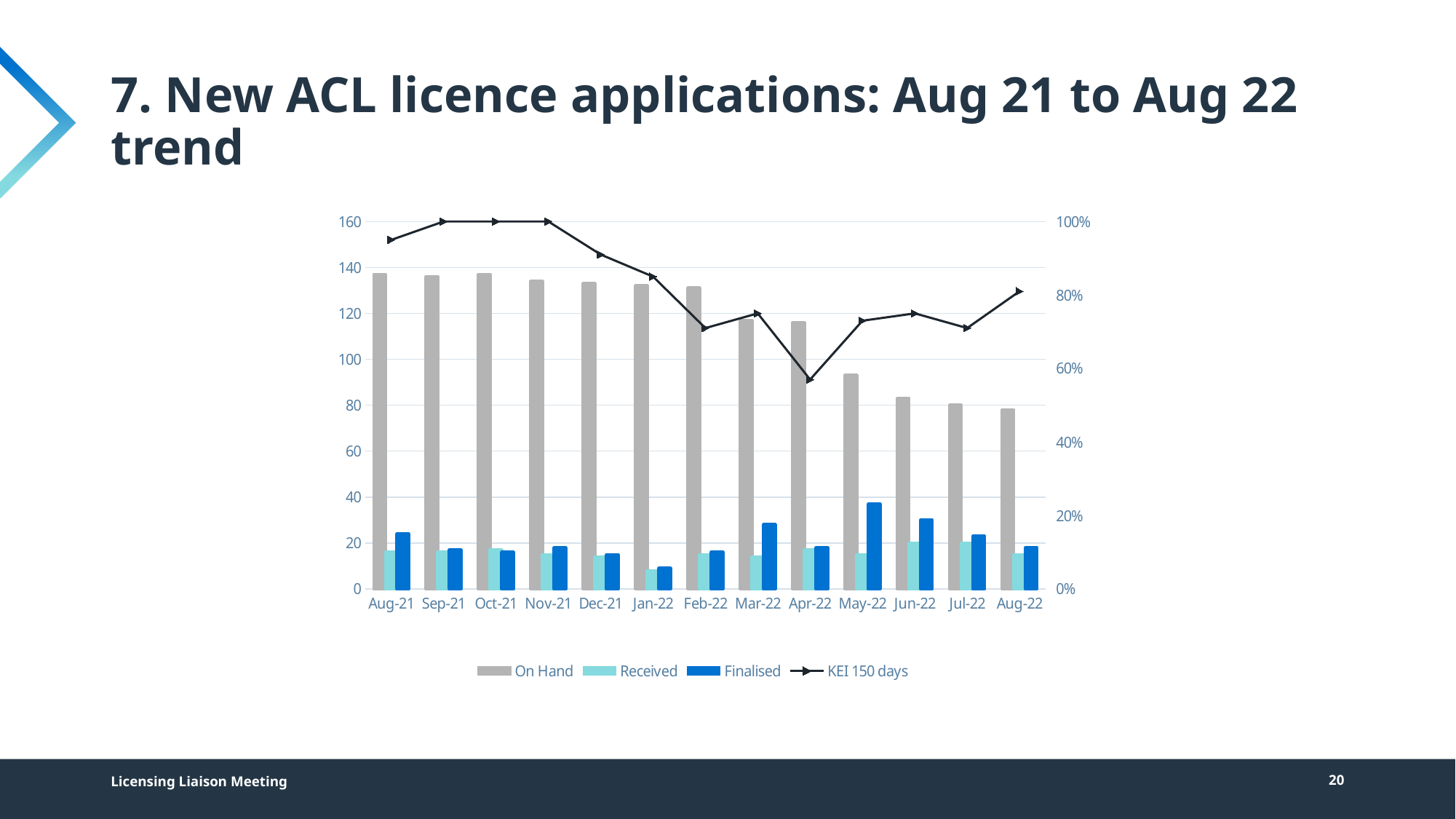
Is the On Hand value for Aug-21 greater or less than 120? greater Which is larger in Aug-21, the Received value or the Finalised value? Finalised How many months are shown along the x axis? 13 Which series is plotted as a line rather than bars? KEI 150 days In which month is the KEI 150 days line at its lowest point? Apr-22 Is the On Hand value for May-22 greater or less than 100? less How many series does the legend list? 4 In which month is the Finalised value highest? May-22 What kind of chart is shown on the slide? bar chart with a line Does the On Hand series rise or fall from Aug-21 to Aug-22? fall Is the KEI 150 days value for Apr-22 greater or less than 80%? less In which month is the Received value lowest? Jan-22